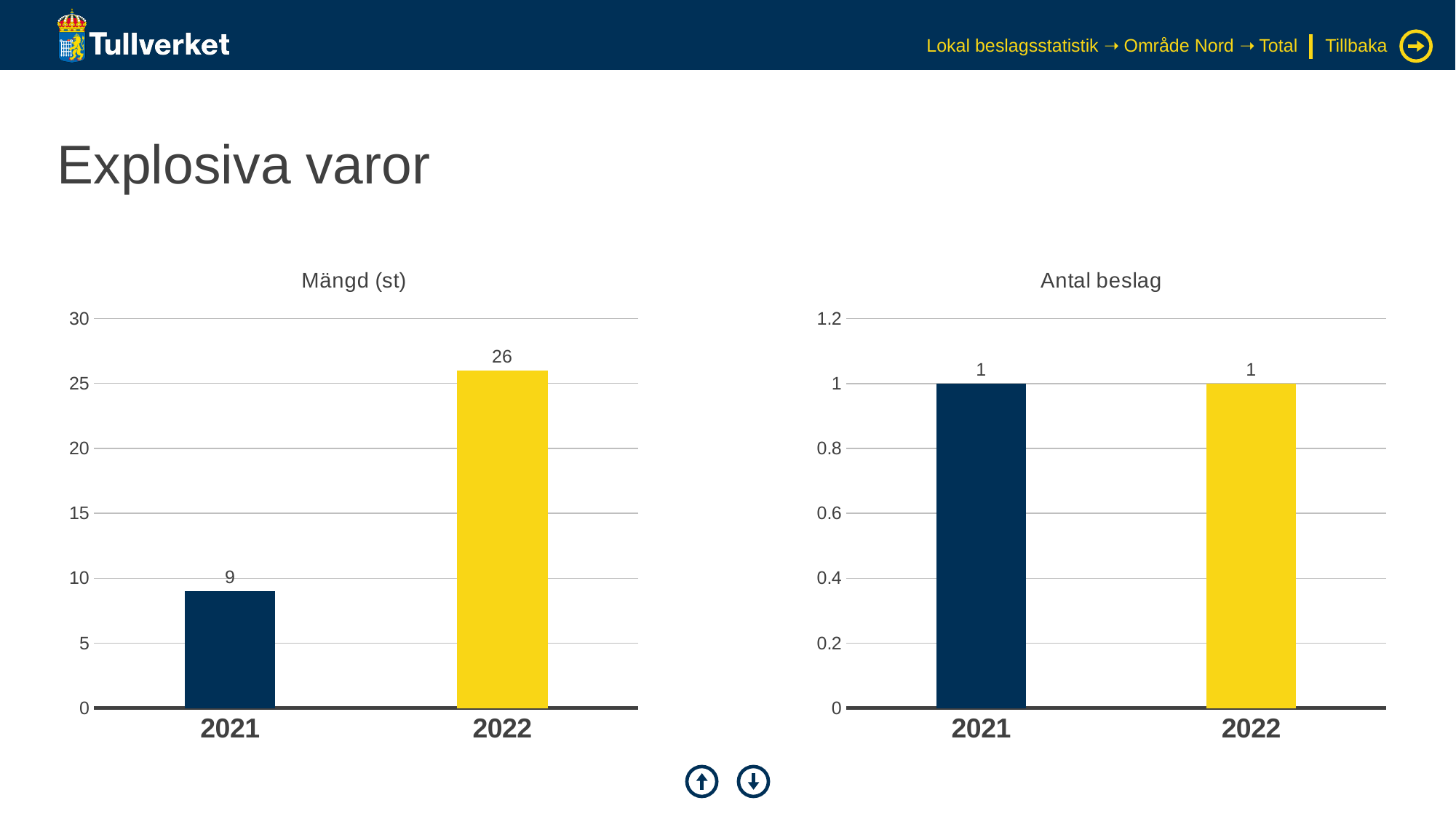
In the 'Mängd (st)' chart, what is the value for 2021? 9 In the 'Antal beslag' chart, what is the value for 2022? 1 In the 'Antal beslag' chart, what is the difference between the values for 2022 and 2021? 0 How many categories does the 'Antal beslag' chart show? 2 In the 'Mängd (st)' chart, which year has the lowest value? 2021 In the 'Mängd (st)' chart, what is the value for 2022? 26 In the 'Mängd (st)' chart, do the values rise or fall from 2021 to 2022? rise In the 'Mängd (st)' chart, what is the difference between the values for 2022 and 2021? 17 In the 'Mängd (st)' chart, which year has the highest value? 2022 What kind of chart is the 'Mängd (st)' chart? bar chart In the 'Mängd (st)' chart, is the value for 2022 greater or less than 25? greater In the 'Antal beslag' chart, what is the value for 2021? 1